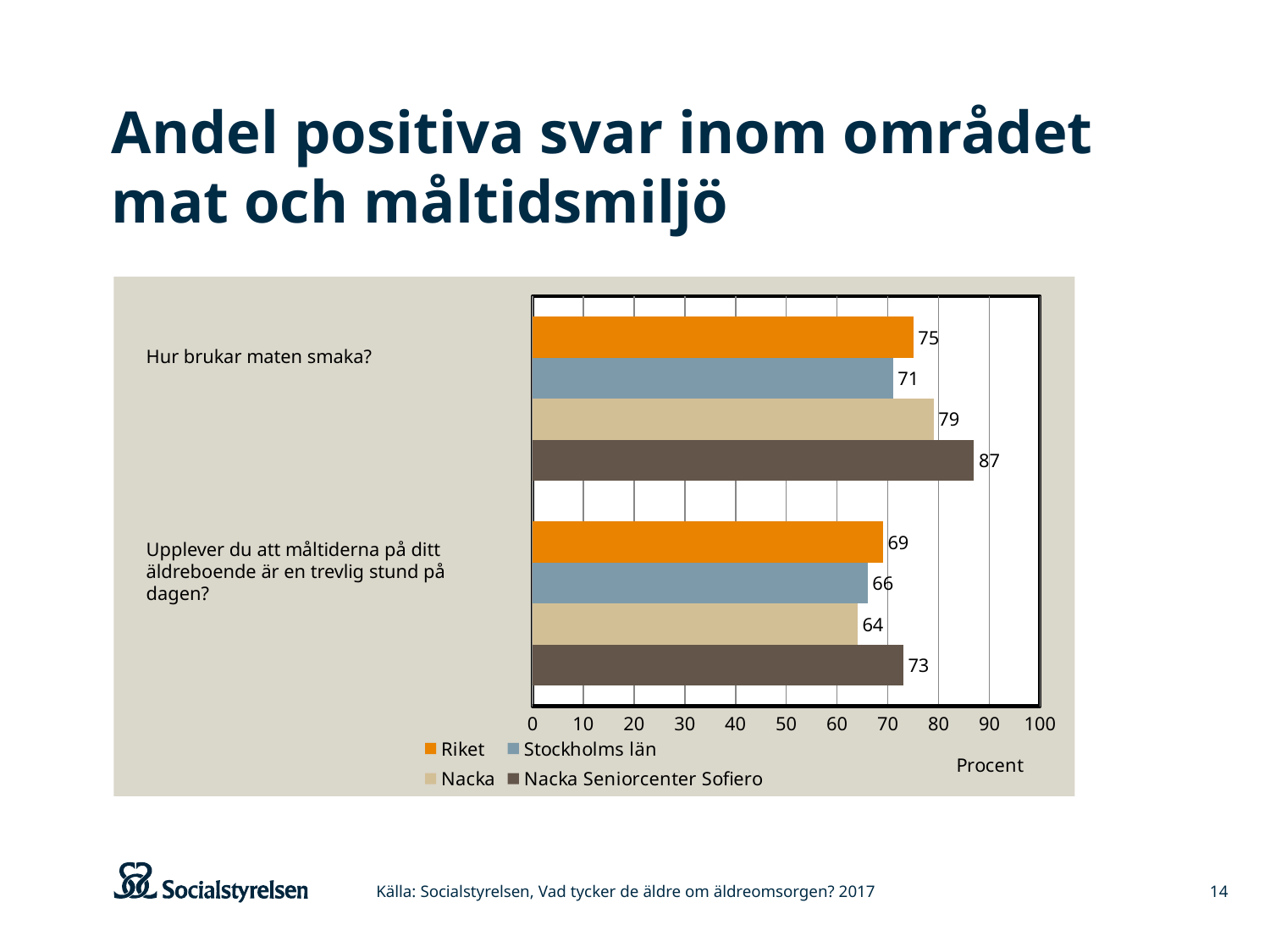
Which series has the lowest value for "Upplever du att måltiderna på ditt äldreboende är en trevlig stund på dagen?"? Nacka What is the value for Stockholms län for "Hur brukar maten smaka?"? 71 Which series has the highest value for "Hur brukar maten smaka?"? Nacka Seniorcenter Sofiero What is the value for Nacka Seniorcenter Sofiero for "Hur brukar maten smaka?"? 87 What is the label of the horizontal axis? Procent What is the value for Riket for "Upplever du att måltiderna på ditt äldreboende är en trevlig stund på dagen?"? 69 How many question categories are shown on the chart? 2 What kind of chart is shown on the slide? Bar chart Which is larger for "Upplever du att måltiderna på ditt äldreboende är en trevlig stund på dagen?": Stockholms län or Nacka Seniorcenter Sofiero? Nacka Seniorcenter Sofiero What is the value for Nacka for "Upplever du att måltiderna på ditt äldreboende är en trevlig stund på dagen?"? 64 What is the difference between Nacka Seniorcenter Sofiero and Riket for "Hur brukar maten smaka?"? 12 How many series does the legend list? 4